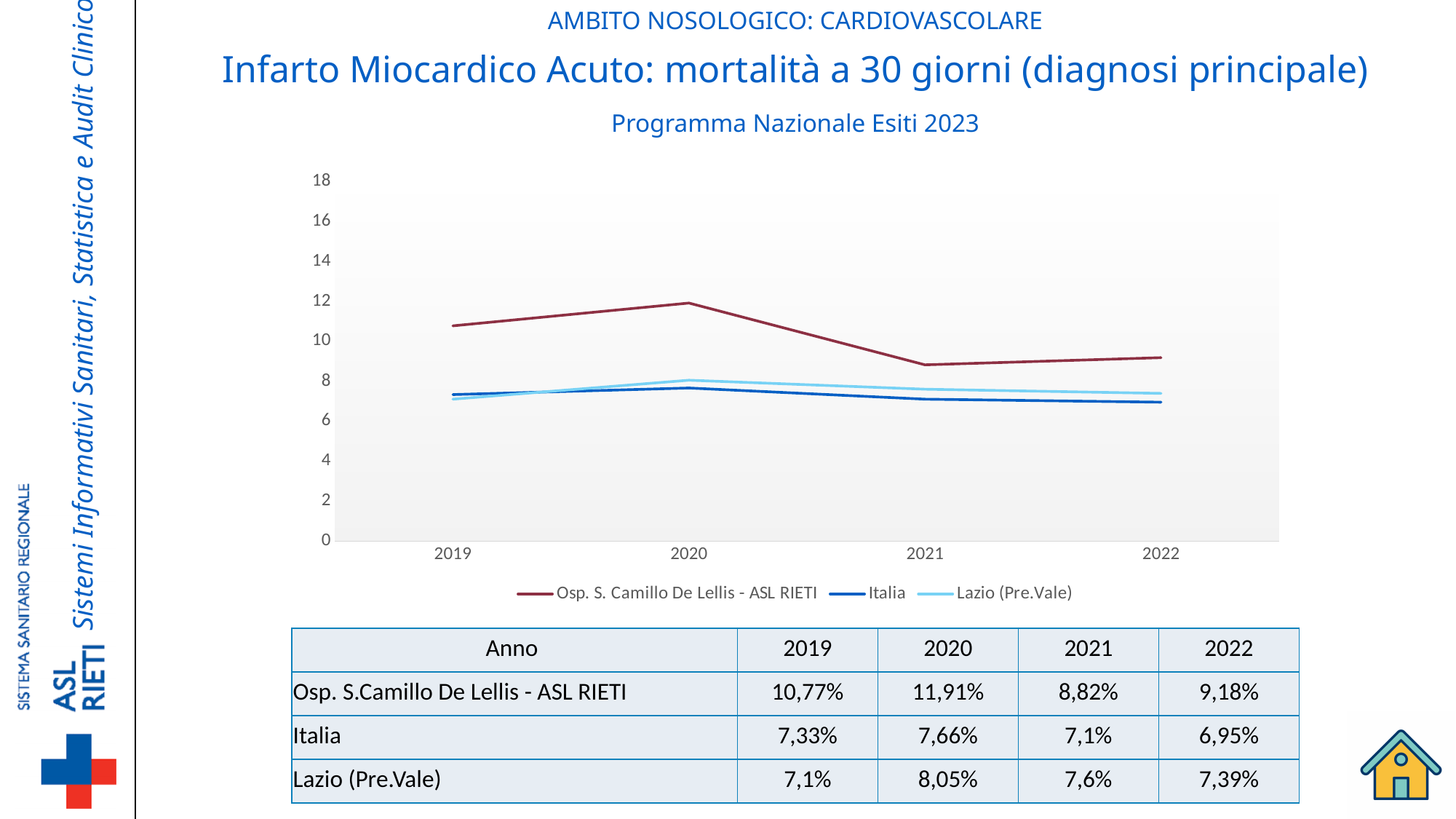
How many years are plotted along the x axis of the chart? 4 In which year does the Osp. S. Camillo De Lellis - ASL RIETI series reach its highest value? 2020 How many series does the chart legend list? 3 Does the Italia series rise or fall from 2020 to 2022? fall In which year does the Italia series reach its lowest value? 2022 What kind of chart is shown on the slide? line chart What is the difference between the Osp. S. Camillo De Lellis - ASL RIETI value and the Italia value in 2019? 3,44% What is the value for Italia in 2022? 6,95% Which is larger in 2020: the value for Lazio (Pre.Vale) or the value for Italia? Lazio (Pre.Vale) Is the value for Osp. S. Camillo De Lellis - ASL RIETI in 2021 greater or less than 10? less What is the value for Osp. S. Camillo De Lellis - ASL RIETI in 2020? 11,91% What is the value for Lazio (Pre.Vale) in 2021? 7,6%